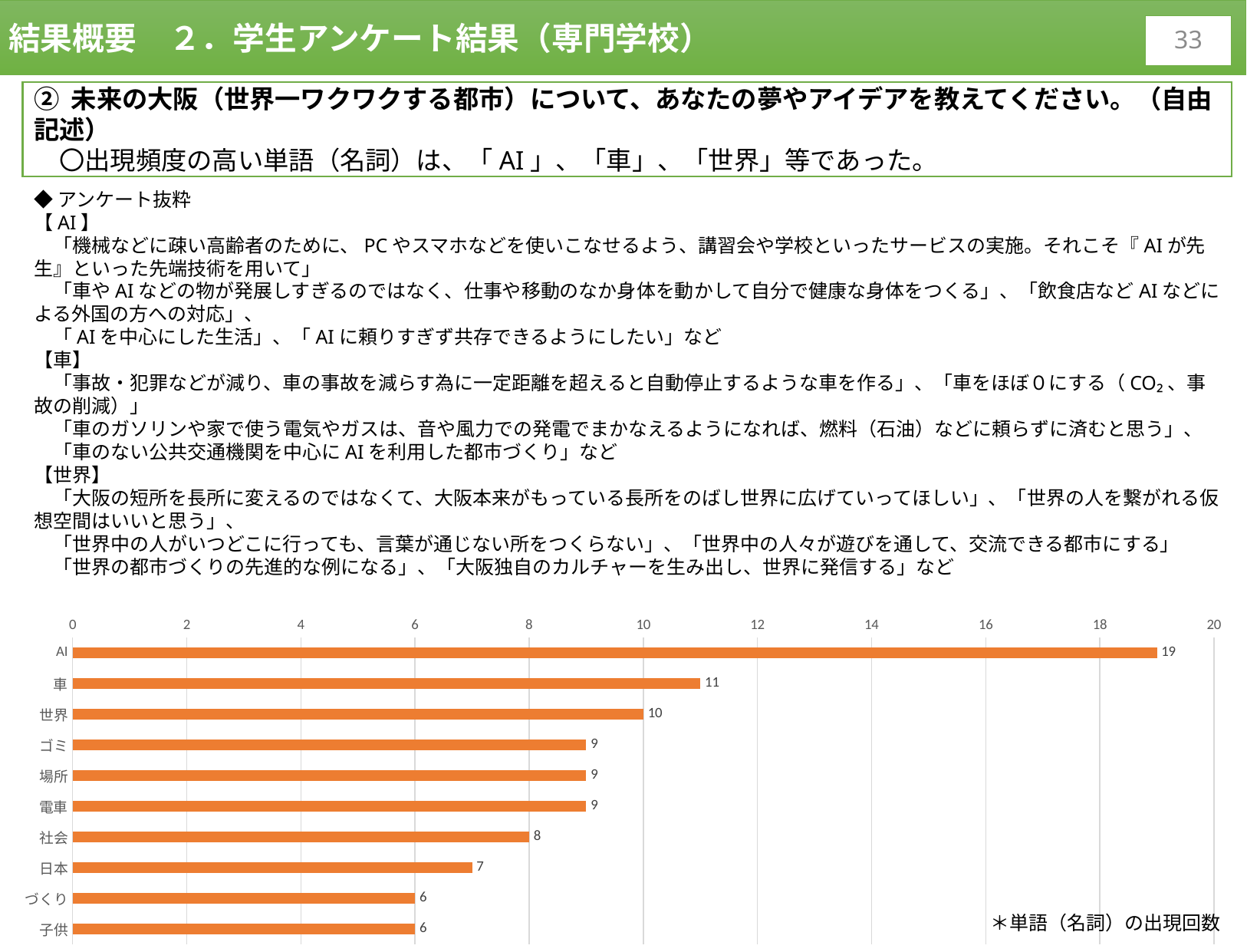
What is the value for 車 in the bar chart? 11 What is the value for AI in the bar chart? 19 How many categories are shown in the bar chart? 10 Which is larger, the value for 車 or the value for 世界? 車 What colour are the bars in the chart? orange Is the value for AI greater or less than 18? greater What is the value for 世界 in the bar chart? 10 What is the difference between the values for AI and 車? 8 Which category has the highest value in the bar chart? AI What is the value for 日本 in the bar chart? 7 What kind of chart is shown on the slide? bar chart What is the difference between the values for 世界 and 社会? 2